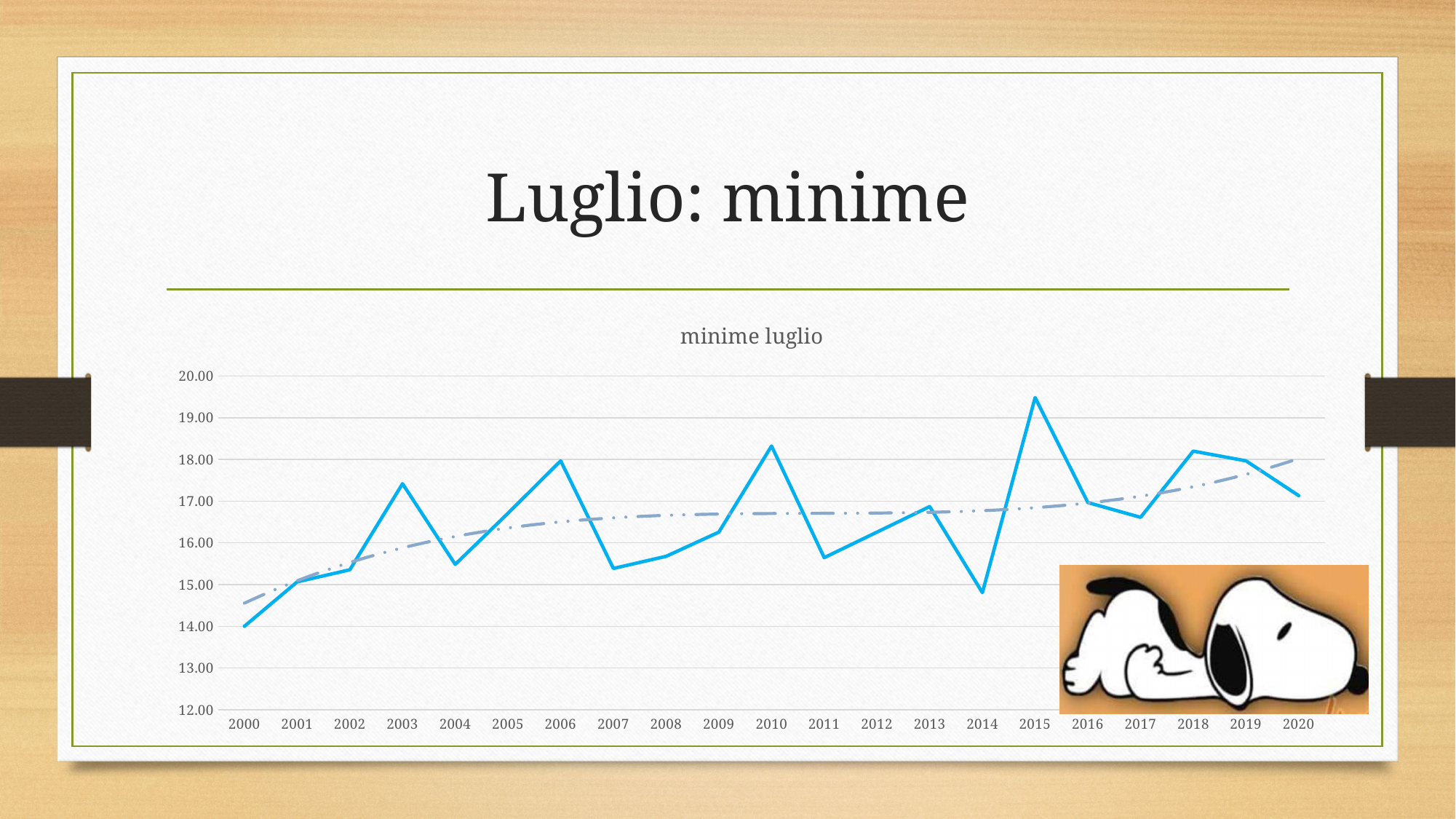
Which year has the lowest value in the chart? 2000 Which year has the larger value, 2013 or 2014? 2013 Is the value for 2015 greater or less than 19.00? greater Which year has the highest value in the chart? 2015 How many years are plotted along the x axis of the chart? 21 What kind of chart is shown on the slide? line chart Which year has the larger value, 2003 or 2004? 2003 Is the value for 2014 greater or less than 15.00? less What is the title of the chart? minime luglio Does the dotted trend line rise or fall from 2000 to 2020? rise Is the value for 2007 greater or less than 16.00? less